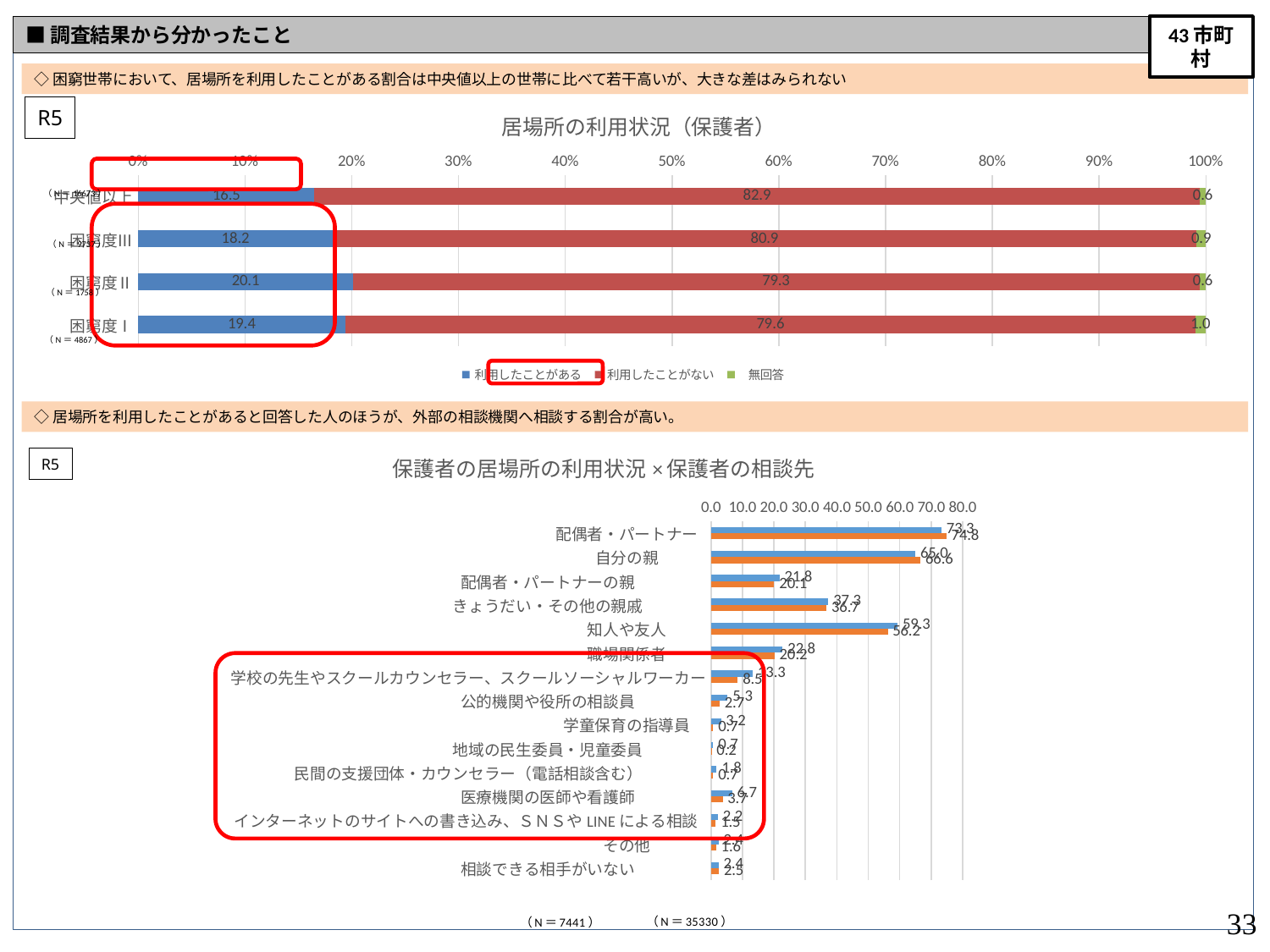
In the top chart '居場所の利用状況（保護者）', how many series does the legend list? 3 In the bottom chart '保護者の居場所の利用状況×保護者の相談先', which category has the highest values? 配偶者・パートナー In the bottom chart '保護者の居場所の利用状況×保護者の相談先', what is the value of the blue bar for 知人や友人? 59.3 In the top chart '居場所の利用状況（保護者）', what is the difference between the 利用したことがある values for 困窮度II and 中央値以上? 3.6 In the bottom chart '保護者の居場所の利用状況×保護者の相談先', how many categories are shown? 15 In the top chart '居場所の利用状況（保護者）', what is the value of 無回答 for 困窮度I? 1.0 In the top chart '居場所の利用状況（保護者）', what is the value of 利用したことがない for 中央値以上? 82.9 In the top chart '居場所の利用状況（保護者）', which category has the highest value for 利用したことがある? 困窮度II In the top chart '居場所の利用状況（保護者）', what is the value of 利用したことがある for 困窮度II? 20.1 In the top chart '居場所の利用状況（保護者）', which category has the lowest value for 利用したことがある? 中央値以上 What kind of chart is the top chart '居場所の利用状況（保護者）'? Stacked bar chart In the bottom chart '保護者の居場所の利用状況×保護者の相談先', is the blue bar or the orange bar larger for 学校の先生やスクールカウンセラー、スクールソーシャルワーカー? Blue bar